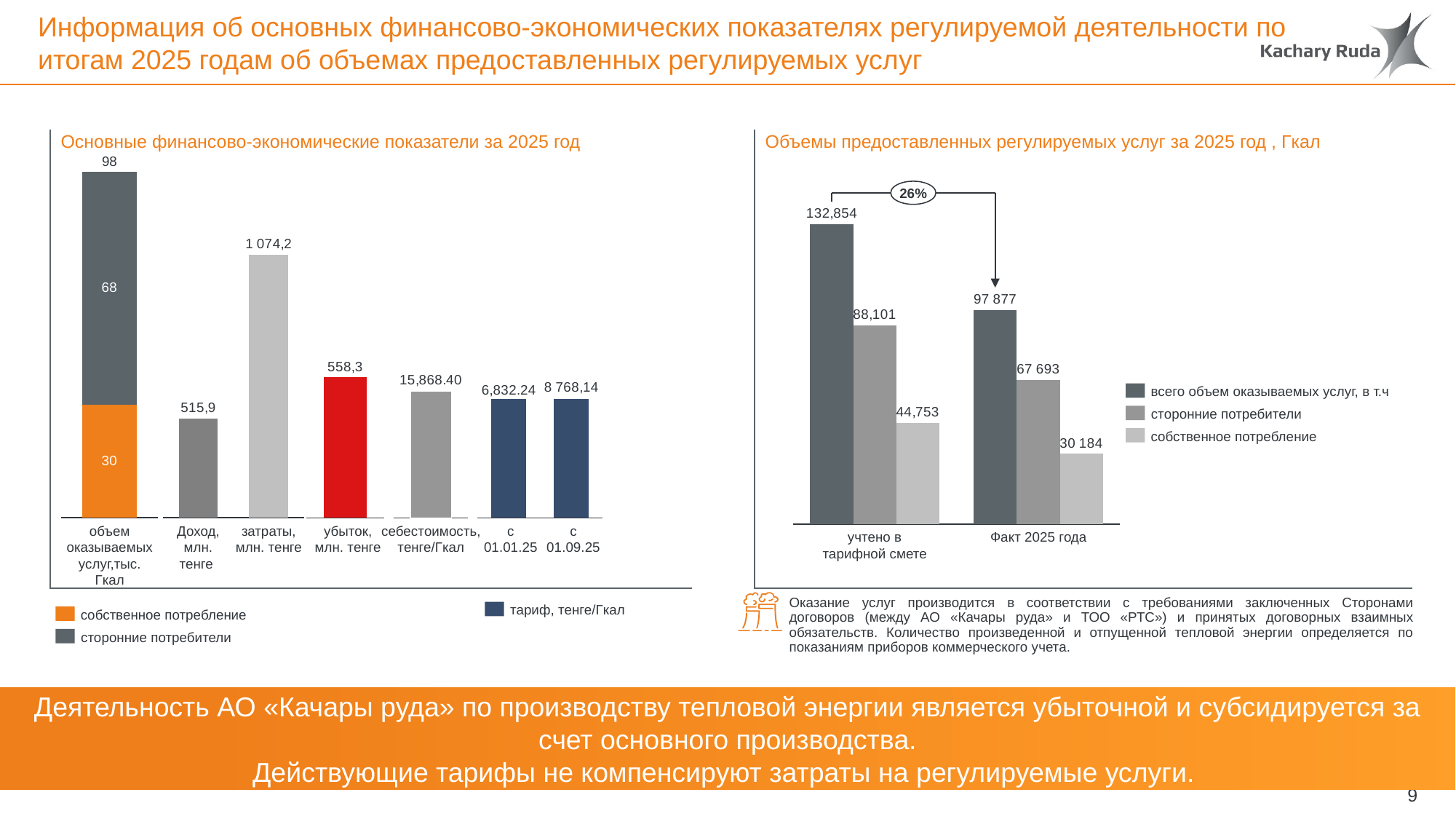
In the chart 'Объемы предоставленных регулируемых услуг за 2025 год, Гкал', what is the value of 'сторонние потребители' for 'учтено в тарифной смете'? 88,101 In the chart 'Основные финансово-экономические показатели за 2025 год', what is the tariff value for 'с 01.09.25'? 8 768,14 What type of chart is 'Объемы предоставленных регулируемых услуг за 2025 год, Гкал'? bar chart In the chart 'Основные финансово-экономические показатели за 2025 год', what is the value for 'убыток, млн. тенге'? 558,3 In the chart 'Объемы предоставленных регулируемых услуг за 2025 год, Гкал', what percentage is shown in the oval annotation between the two 'всего объем' bars? 26% In the chart 'Объемы предоставленных регулируемых услуг за 2025 год, Гкал', which is larger: 'сторонние потребители' for 'учтено в тарифной смете' or for 'Факт 2025 года'? учтено в тарифной смете In the chart 'Объемы предоставленных регулируемых услуг за 2025 год, Гкал', how many series does the legend list? 3 In the chart 'Основные финансово-экономические показатели за 2025 год', what is the value for 'затраты, млн. тенге'? 1 074,2 In the chart 'Основные финансово-экономические показатели за 2025 год', what is the 'собственное потребление' segment of the stacked bar 'объем оказываемых услуг, тыс. Гкал'? 30 In the chart 'Основные финансово-экономические показатели за 2025 год', what is the total of the stacked bar 'объем оказываемых услуг, тыс. Гкал'? 98 In the chart 'Объемы предоставленных регулируемых услуг за 2025 год, Гкал', what is the value of 'всего объем оказываемых услуг' for 'учтено в тарифной смете'? 132,854 In the chart 'Объемы предоставленных регулируемых услуг за 2025 год, Гкал', what is the value of 'собственное потребление' for 'Факт 2025 года'? 30 184